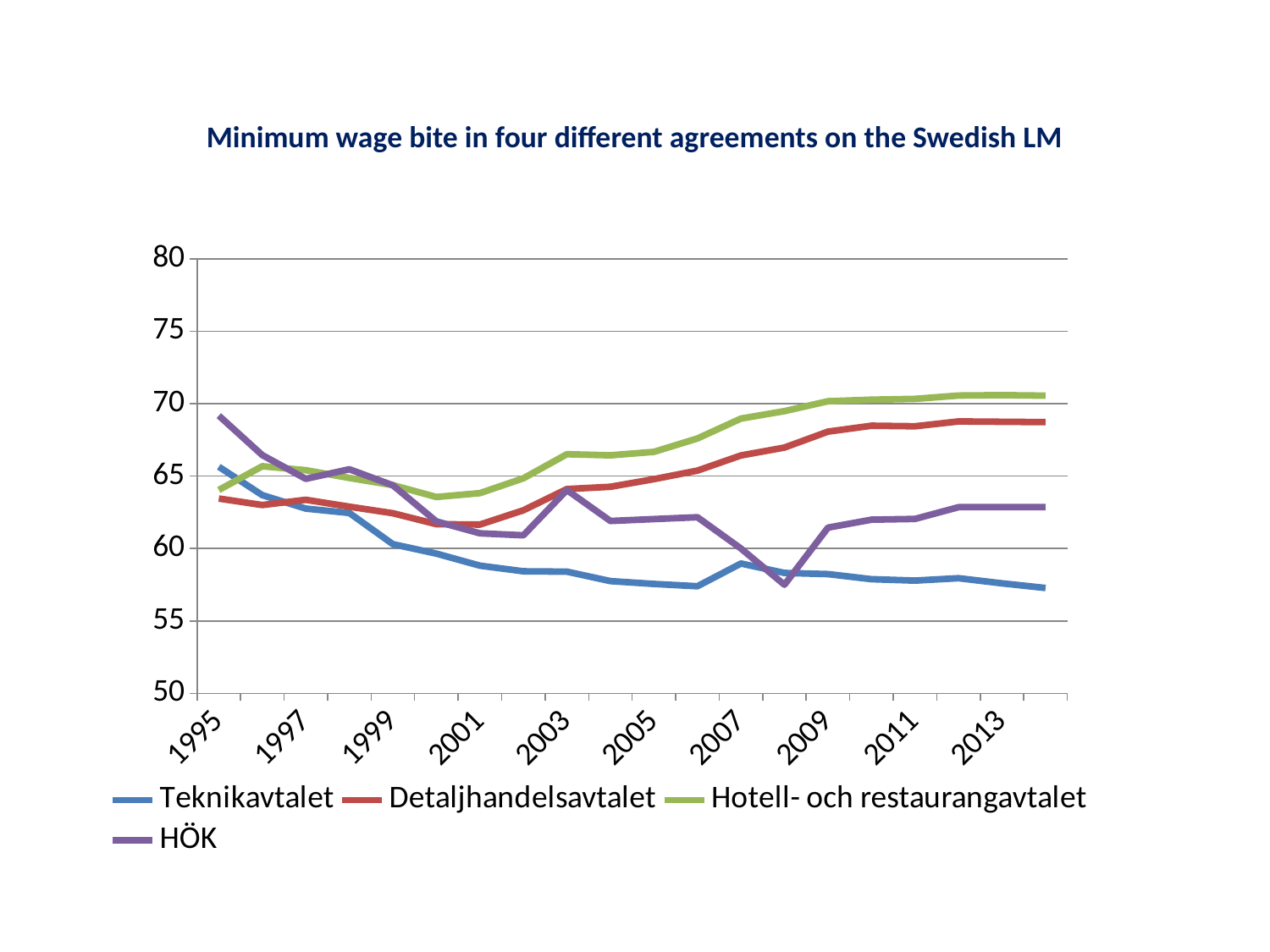
Which series has the lowest value in 2013? Teknikavtalet Which series has the highest value in 1995? HÖK What is the title of the chart? Minimum wage bite in four different agreements on the Swedish LM Is the value for Teknikavtalet in 2013 greater or less than 60? less Which series has the highest value in 2013? Hotell- och restaurangavtalet How many series does the legend list? 4 Is the value for Hotell- och restaurangavtalet in 2009 greater or less than 65? greater Does the Teknikavtalet line generally rise or fall from 1995 to 2013? fall Which series is shown in green in the legend? Hotell- och restaurangavtalet What kind of chart is shown on the slide? line chart Is the value for HÖK in 1995 greater or less than 65? greater In 1995, which is larger: the value for HÖK or the value for Detaljhandelsavtalet? HÖK